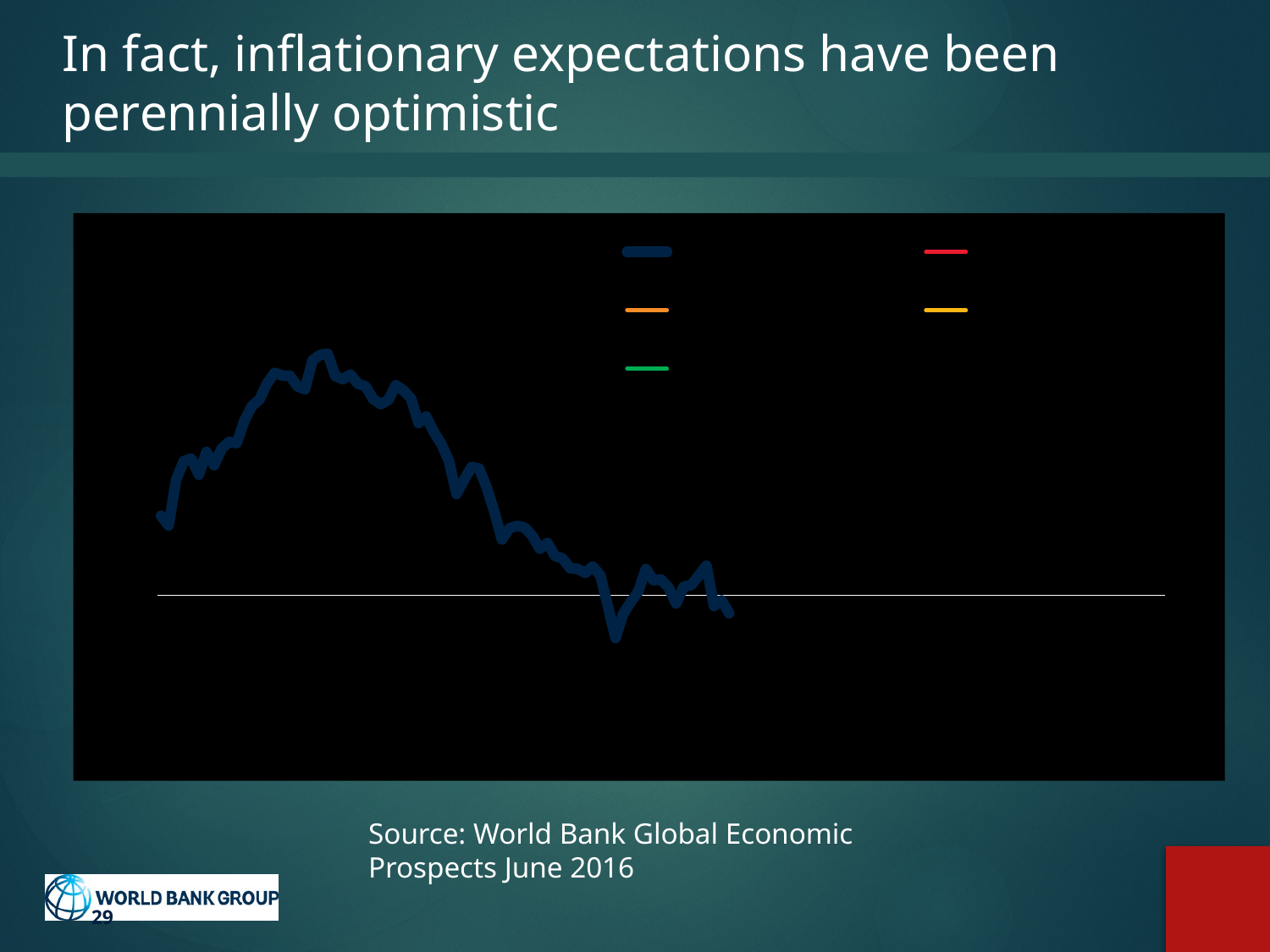
What source is cited below the chart? World Bank Global Economic Prospects June 2016 How many lines are actually plotted on the chart? 1 What colour is the plotted line on the chart? dark blue What kind of chart is shown on the slide? line chart Over the right-hand half of the plotted line, do the values rise or fall? fall How many series does the chart's legend list (by its coloured markers)? 5 Does the plotted line end higher or lower than where it starts? lower